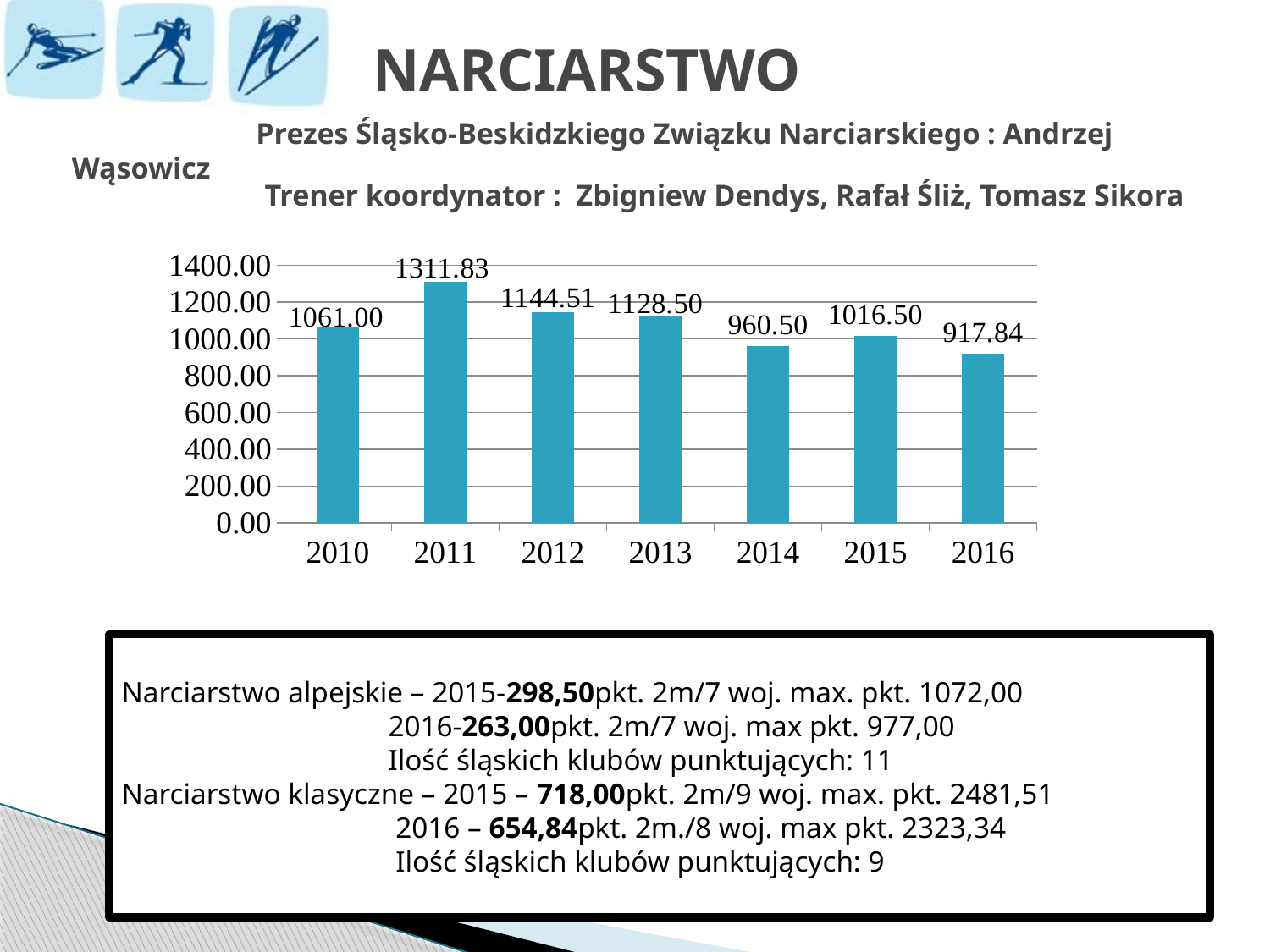
Which year has the lowest value in the bar chart? 2016 Do the values rise or fall from 2011 to 2014? fall Is the value for 2014 greater or less than 1000? less Which year has the highest value in the bar chart? 2011 What is the value shown for 2011 in the bar chart? 1311.83 What is the difference between the values for 2011 and 2010? 250.83 Which year has the larger value, 2014 or 2015? 2015 What is the value shown for 2016 in the bar chart? 917.84 How many years are shown on the x axis of the bar chart? 7 What kind of chart is shown on the slide? bar chart What is the difference between the values for 2015 and 2014? 56.00 What is the value shown for 2014 in the bar chart? 960.50